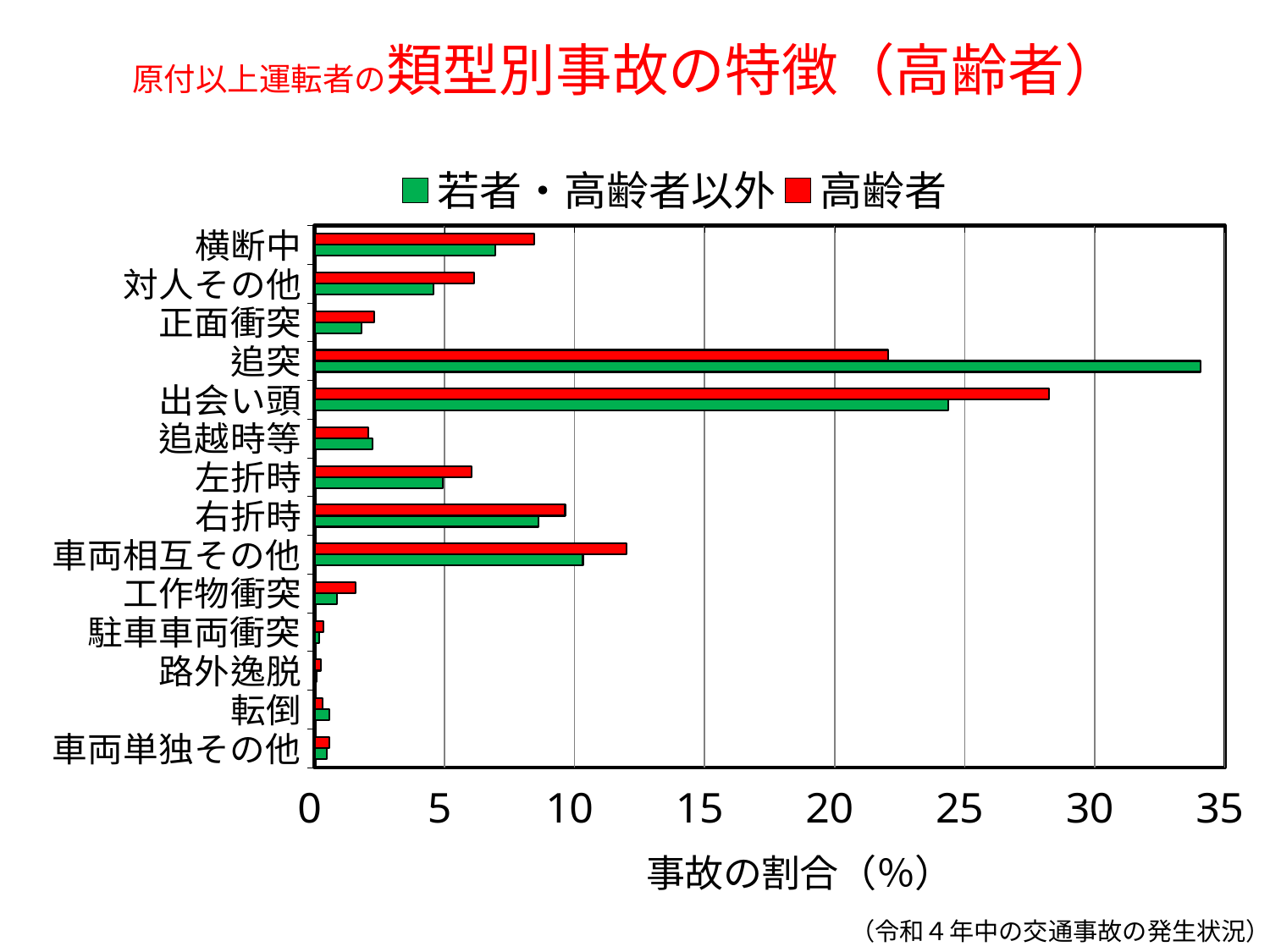
For 出会い頭, which series has the larger value, 若者・高齢者以外 or 高齢者? 高齢者 Is the 高齢者 value for 出会い頭 greater or less than 25? greater Which category has the highest value for the 高齢者 series? 出会い頭 How many series does the legend list? 2 Which category has the highest value for the 若者・高齢者以外 series? 追突 For 追突, which series has the larger value, 若者・高齢者以外 or 高齢者? 若者・高齢者以外 What is the label of the x axis? 事故の割合（%） Is the 高齢者 value for 車両相互その他 greater or less than 10? greater How many accident-type categories are plotted on the y axis? 14 Is the 高齢者 value for 正面衝突 greater or less than 5? less What kind of chart is shown on the slide? bar chart